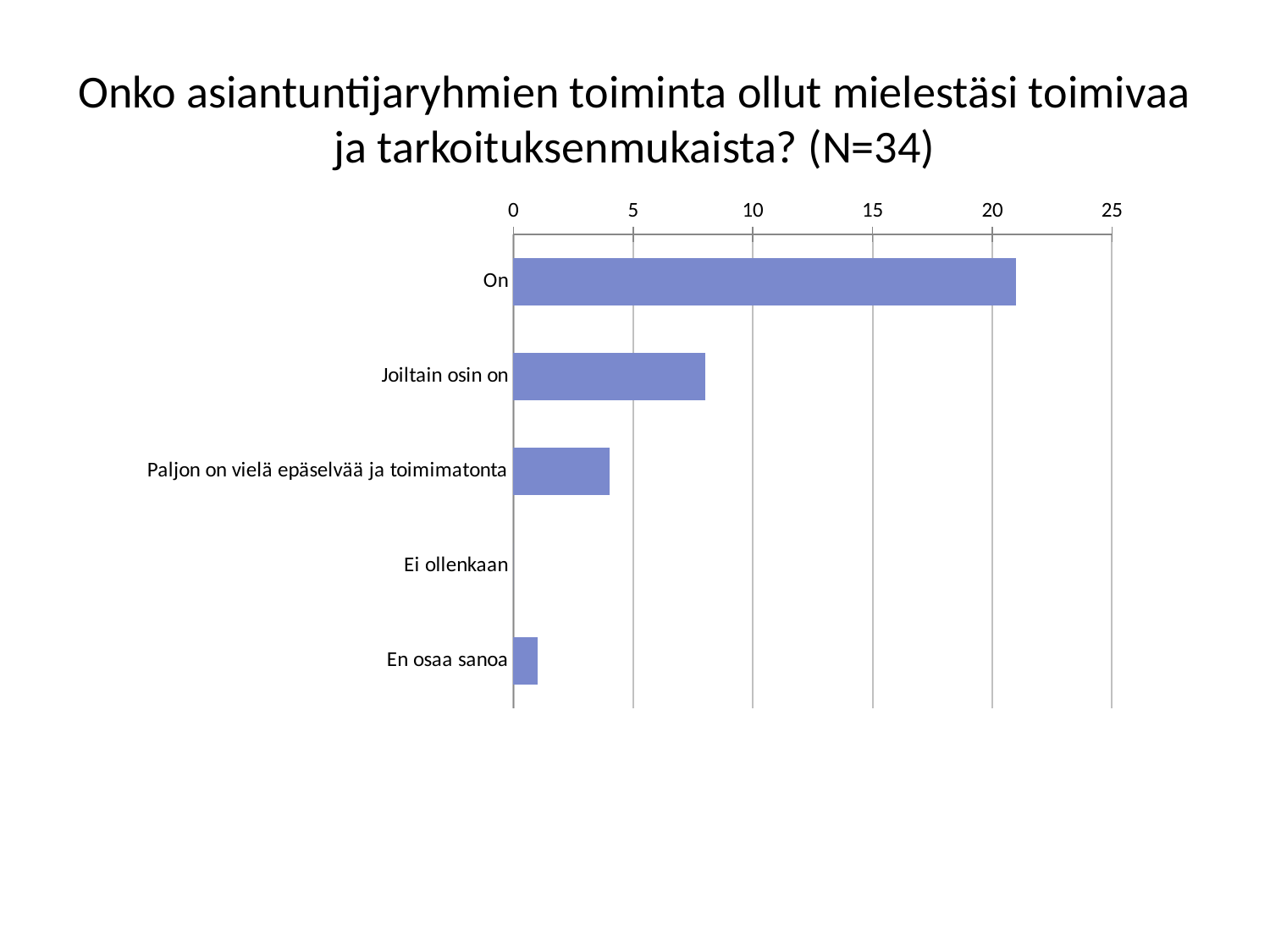
Is the value for "On" greater or less than 20? greater What is the value for "Ei ollenkaan"? 0 Is the value for "Joiltain osin on" greater or less than 10? less Is the value for "En osaa sanoa" greater or less than 5? less Which category has the highest value? On What is the maximum value shown on the horizontal axis? 25 How many categories are shown on the chart? 5 Which category has the lowest value? Ei ollenkaan Which is larger, the value for "Joiltain osin on" or the value for "Paljon on vielä epäselvää ja toimimatonta"? Joiltain osin on What kind of chart is shown on the slide? bar chart